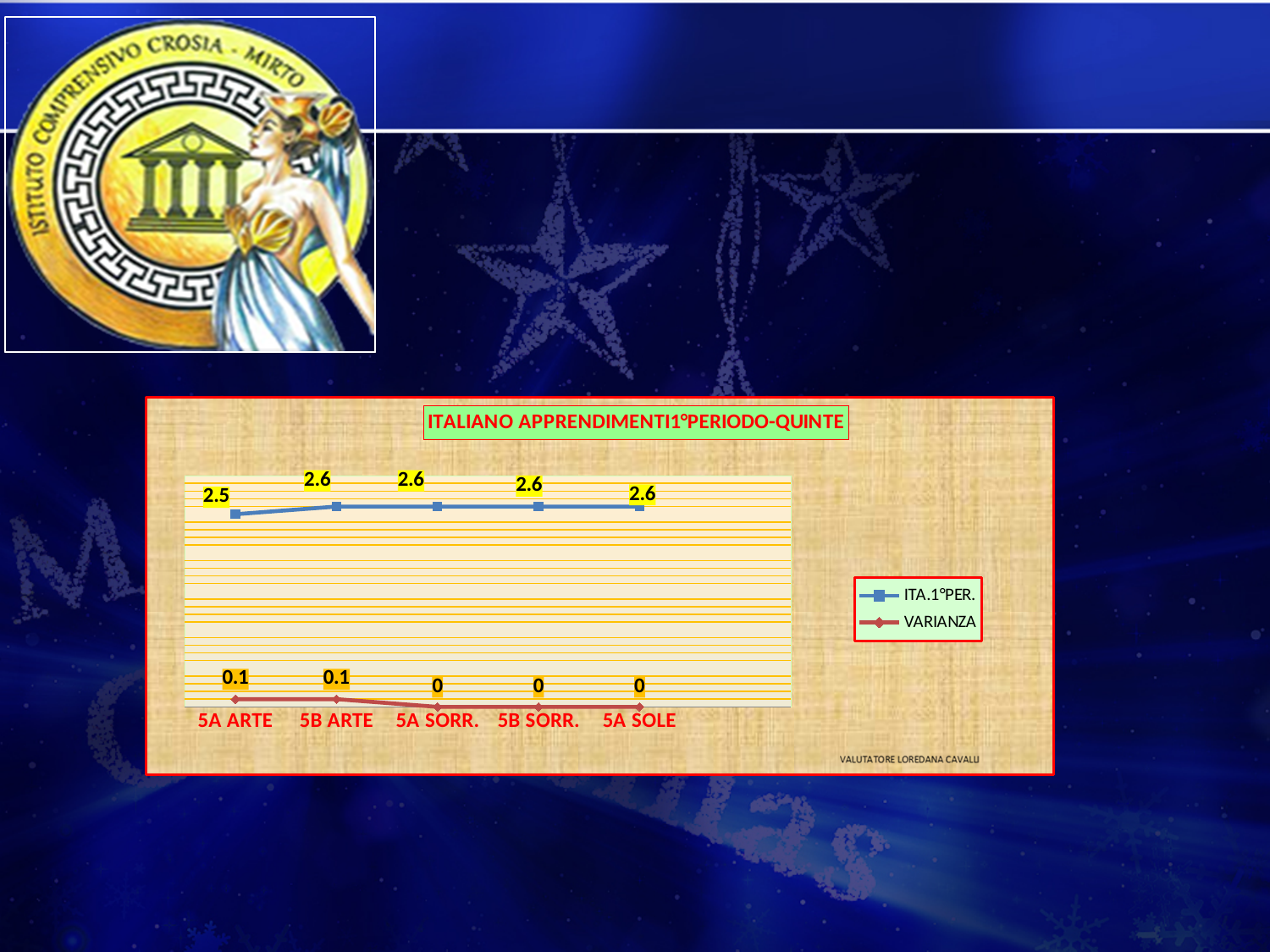
What is the ITA.1°PER. value for 5A ARTE? 2.5 What is the VARIANZA value for 5A SORR.? 0 Which category has the lowest ITA.1°PER. value? 5A ARTE What kind of chart is shown? line chart How many categories are shown on the x axis? 5 Does the VARIANZA series rise or fall from 5B ARTE to 5A SORR.? fall What is the VARIANZA value for 5B ARTE? 0.1 Which is larger, the VARIANZA value for 5A ARTE or for 5B SORR.? 5A ARTE What is the title of the chart? ITALIANO APPRENDIMENTI1°PERIODO-QUINTE What is the ITA.1°PER. value for 5A SOLE? 2.6 What is the difference between the ITA.1°PER. values for 5B ARTE and 5A ARTE? 0.1 How many series does the legend list? 2